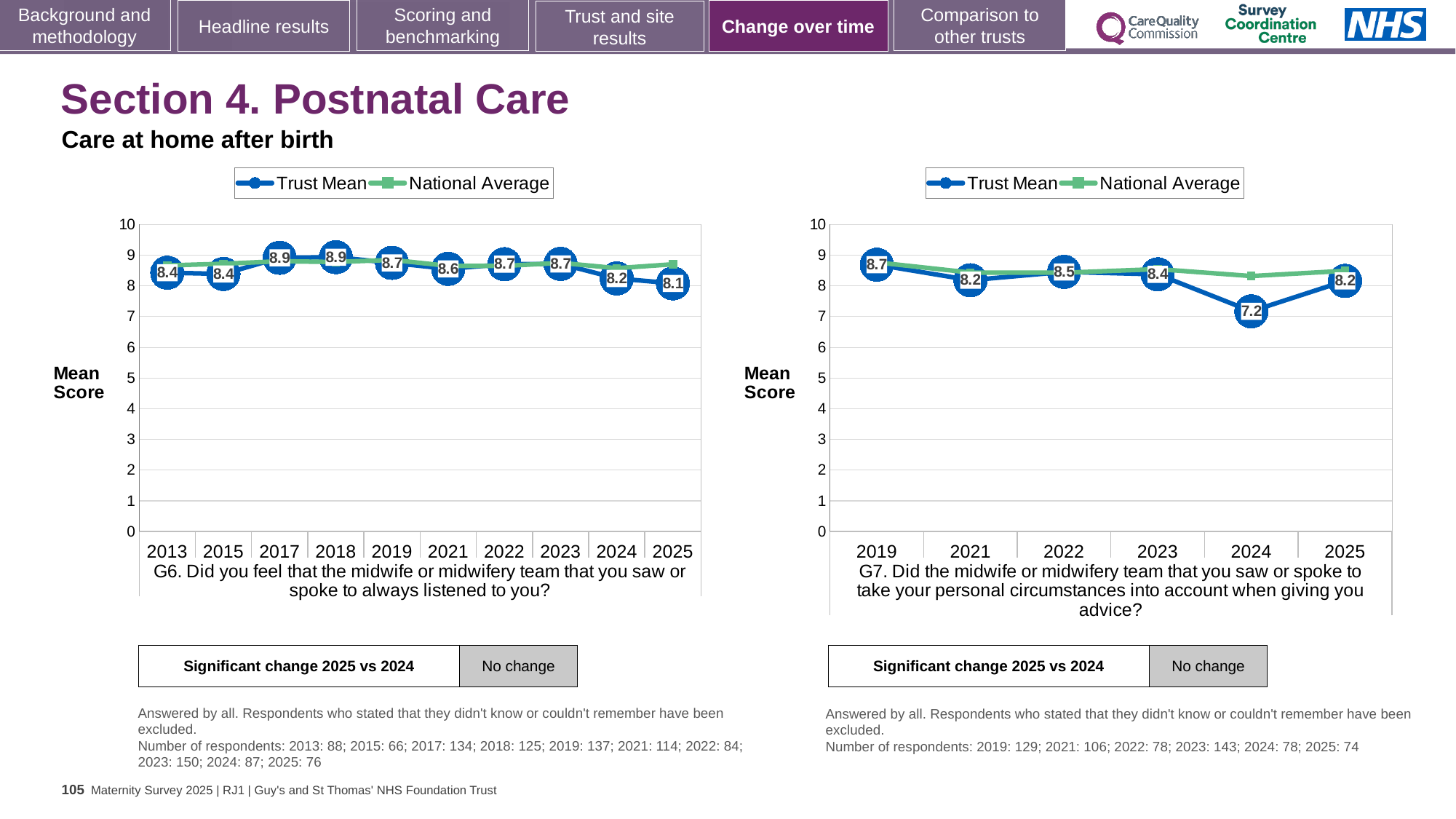
In the G6 chart (left), is the Trust Mean higher in 2013 or in 2024? 2013 In the G7 chart (right), which year has the lowest Trust Mean? 2024 In the G7 chart (right), what is the difference between the Trust Mean in 2019 and in 2024? 1.5 In the G7 chart (right), what is the Trust Mean for 2024? 7.2 In the G6 chart (left), what is the Trust Mean for 2017? 8.9 In the G7 chart (right), which year has the highest Trust Mean? 2019 What type of chart is the G6 chart (left)? Line chart In the G7 chart (right), is the National Average for 2024 greater or less than 7? greater How many years are plotted in the G6 chart (left)? 10 How many series does the legend of the G7 chart (right) list? 2 In the G6 chart (left), what is the difference between the Trust Mean in 2018 and in 2025? 0.8 In the G6 chart (left), what is the Trust Mean for 2025? 8.1